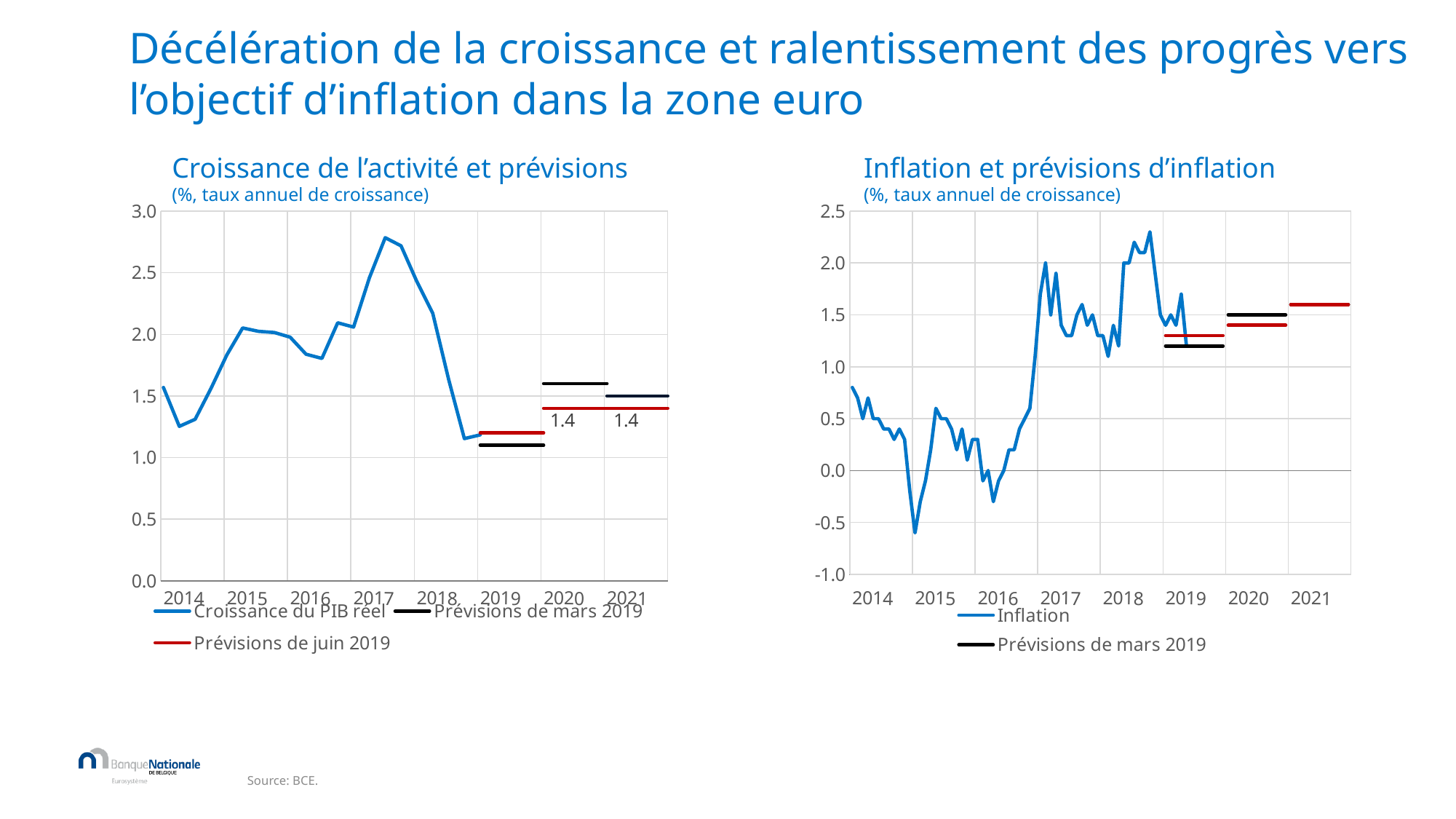
What kind of chart is the 'Croissance de l’activité et prévisions' chart? line chart In the 'Croissance de l’activité et prévisions' chart, is the peak value of 'Croissance du PIB réel' in 2017 greater or less than 2.5? greater In the 'Croissance de l’activité et prévisions' chart, what is the 'Prévisions de juin 2019' value for 2020? 1.4 How many series does the legend of the 'Croissance de l’activité et prévisions' chart list? 3 In the 'Inflation et prévisions d’inflation' chart, is the peak value of 'Inflation' in 2018 greater or less than 2.0? greater In the 'Inflation et prévisions d’inflation' chart, which year has the higher 'Prévisions de mars 2019' value: 2019 or 2020? 2020 In the 'Croissance de l’activité et prévisions' chart, which is higher for 2020: 'Prévisions de mars 2019' or 'Prévisions de juin 2019'? Prévisions de mars 2019 In the 'Croissance de l’activité et prévisions' chart, what is the 'Prévisions de juin 2019' value for 2021? 1.4 How many years are labelled on the x axis of the 'Inflation et prévisions d’inflation' chart? 8 In the 'Inflation et prévisions d’inflation' chart, is the lowest value of 'Inflation' greater or less than 0.0? less In the 'Croissance de l’activité et prévisions' chart, does 'Croissance du PIB réel' rise or fall between its 2017 peak and 2019? fall How many series does the legend of the 'Inflation et prévisions d’inflation' chart list? 2